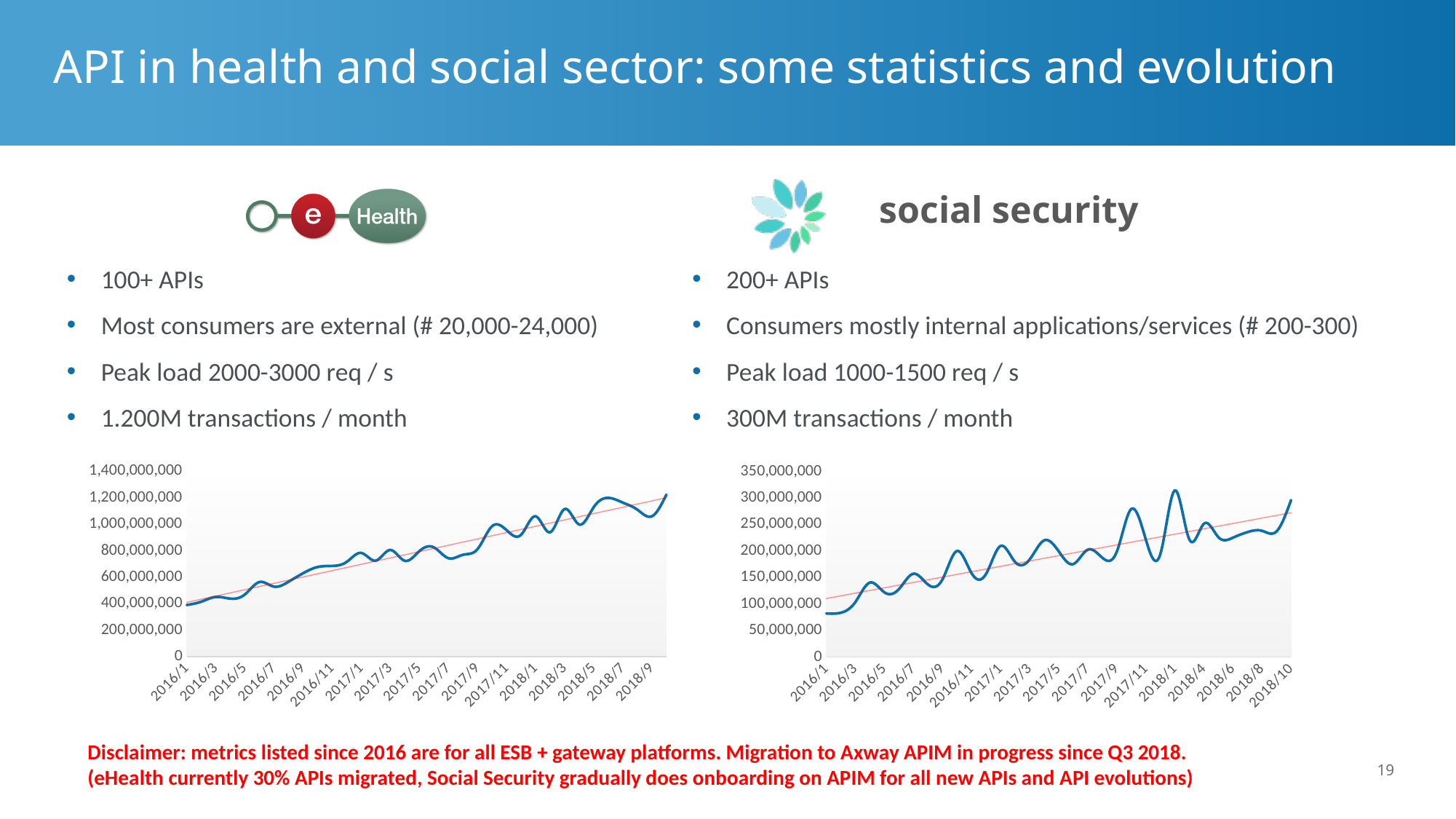
What is the highest value shown on the y axis of the right (social security) chart? 350,000,000 In the right (social security) chart, is the value for 2017/1 greater or less than 150,000,000? greater In the left (eHealth) chart, is the value for 2018/9 greater or less than 1,000,000,000? greater What kind of chart is shown under the eHealth section on the left of the slide? line chart What is the highest value shown on the y axis of the left (eHealth) chart? 1,400,000,000 In the right (social security) chart, is the value for 2016/1 greater or less than 100,000,000? less What kind of chart is shown under the social security section on the right of the slide? line chart In the right (social security) chart, do the values generally rise or fall from 2016/1 to 2018/10? rise In the left (eHealth) chart, do the values generally rise or fall from 2016/1 to 2018/9? rise